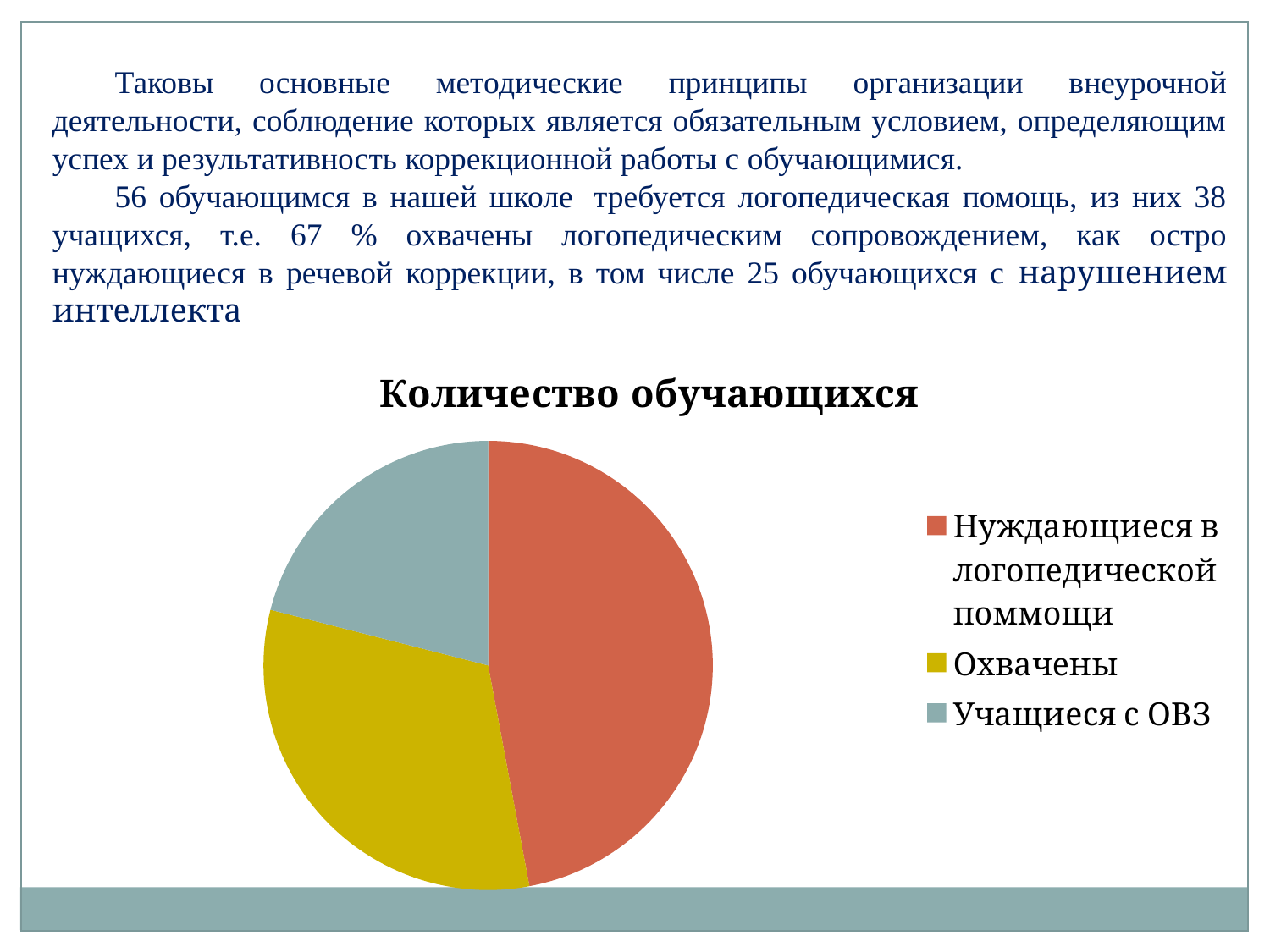
Which category has the smallest slice of the pie? Учащиеся с ОВЗ Which slice is larger: Охвачены or Учащиеся с ОВЗ? Охвачены What is the title of the chart? Количество обучающихся Which slice is larger: Нуждающиеся в логопедической поммощи or Охвачены? Нуждающиеся в логопедической поммощи How many slices does the pie chart have? 3 What kind of chart is shown on the slide? pie chart How many entries does the chart legend list? 3 What colour is the slice for Охвачены? yellow Which category has the largest slice of the pie? Нуждающиеся в логопедической поммощи